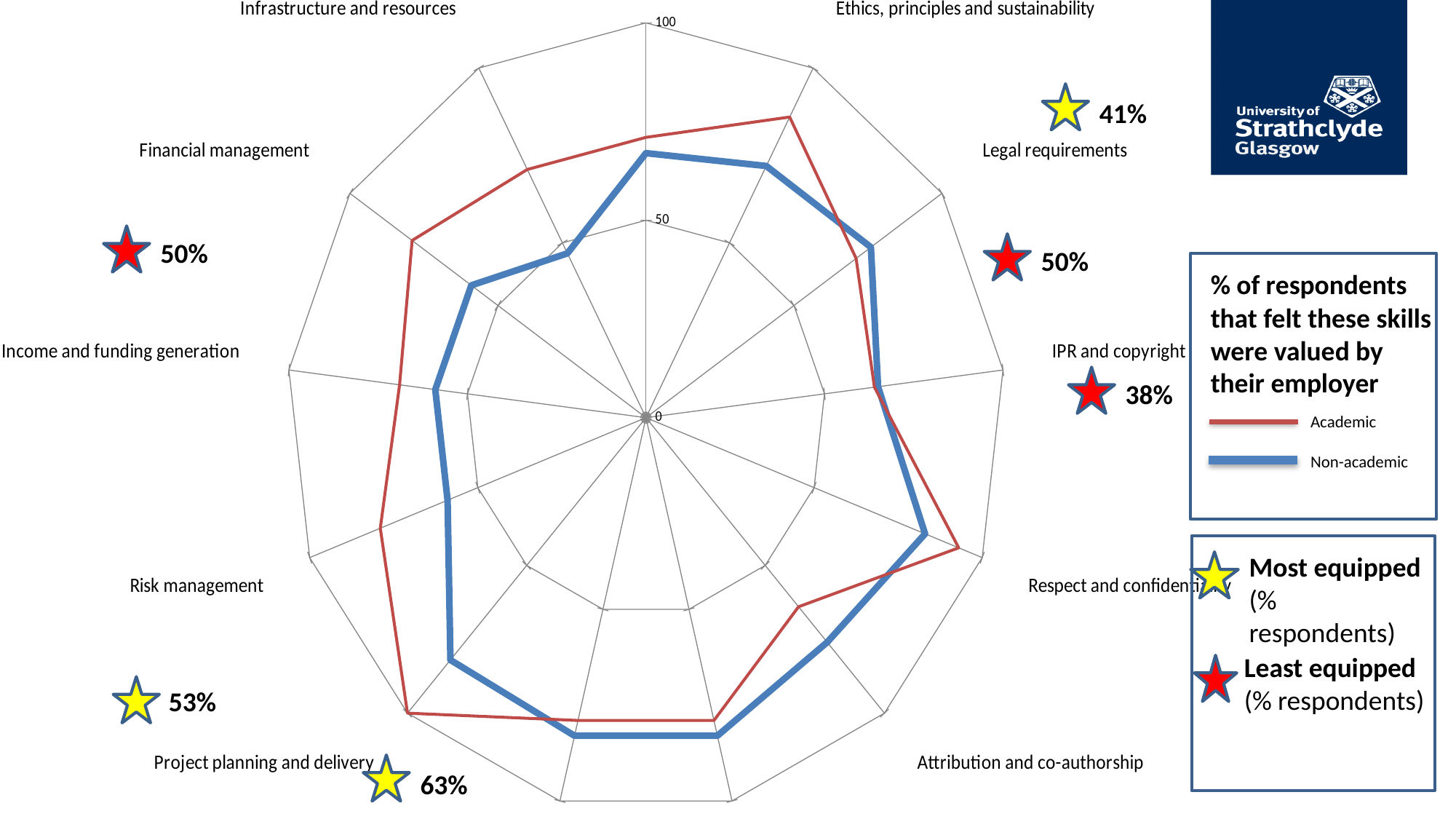
Is the Academic value for Ethics, principles and sustainability greater or less than 50? greater For Risk management, which series has the higher value, Academic or Non-academic? Academic What kind of chart is shown on the slide? Radar chart How many series does the chart's legend list? 2 For Ethics, principles and sustainability, which series has the higher value, Academic or Non-academic? Academic For which category does the Academic series reach its highest value? Project planning and delivery Which series is drawn in blue on the chart? Non-academic Is the Academic value for Project planning and delivery greater or less than 50? greater Is the Non-academic value for Attribution and co-authorship greater or less than 50? greater What percentage of respondents is shown by the star next to Project planning and delivery? 63% For Financial management, which series has the higher value, Academic or Non-academic? Academic What is the title given for the chart in the legend box? % of respondents that felt these skills were valued by their employer